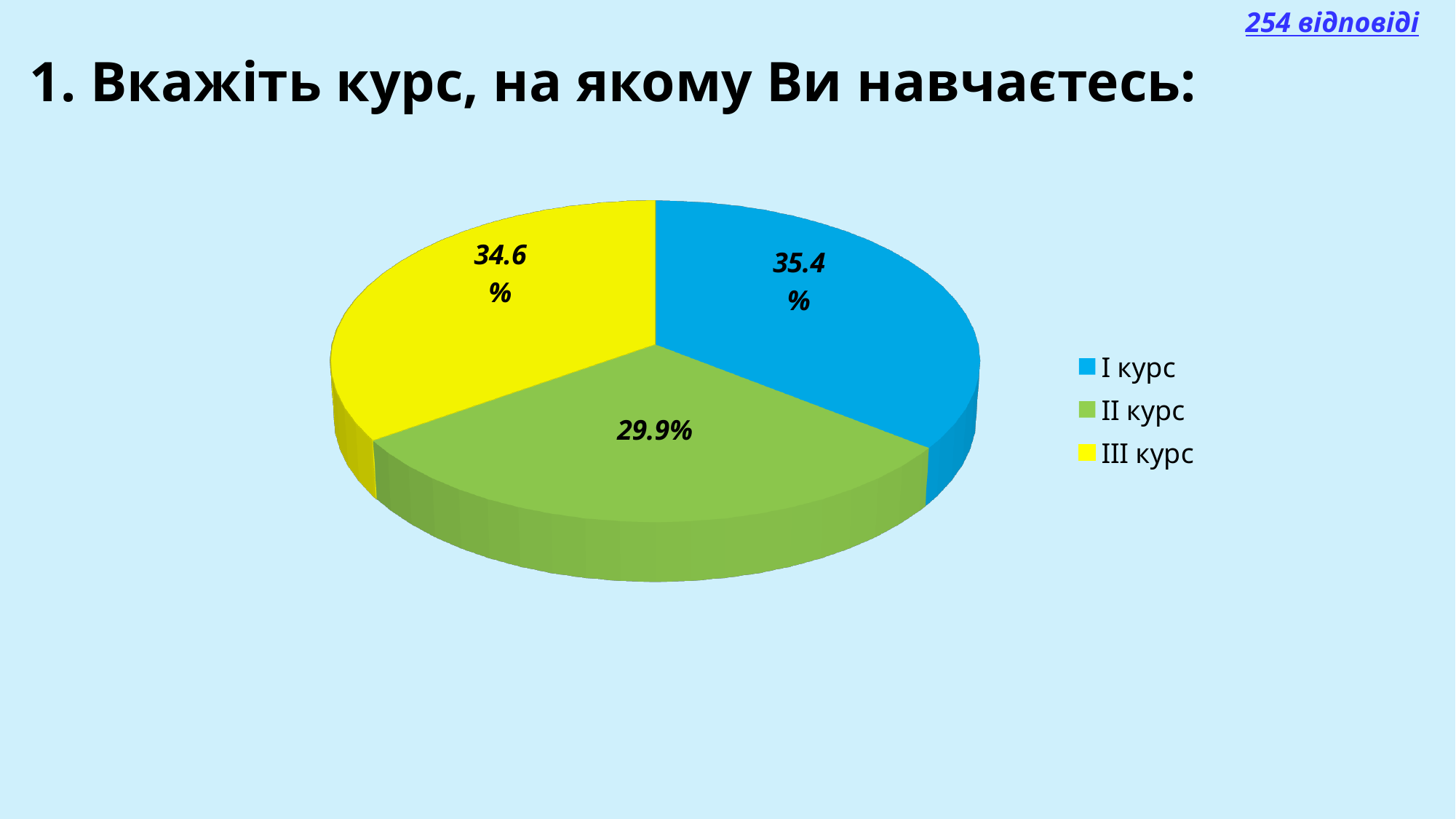
How many responses does the slide say the survey received? 254 What is the difference in percentage points between I курс and II курс? 5.5 Which course has the smallest share of respondents? II курс What percentage of respondents are in II курс? 29.9% Which course has the largest share of respondents? I курс What colour is the slice for II курс? Green What percentage of respondents are in III курс? 34.6% Which has a larger share, II курс or III курс? III курс How many slices does the pie chart have? 3 What percentage of respondents are in I курс? 35.4% What type of chart is shown on the slide? Pie chart What is the difference in percentage points between III курс and II курс? 4.7